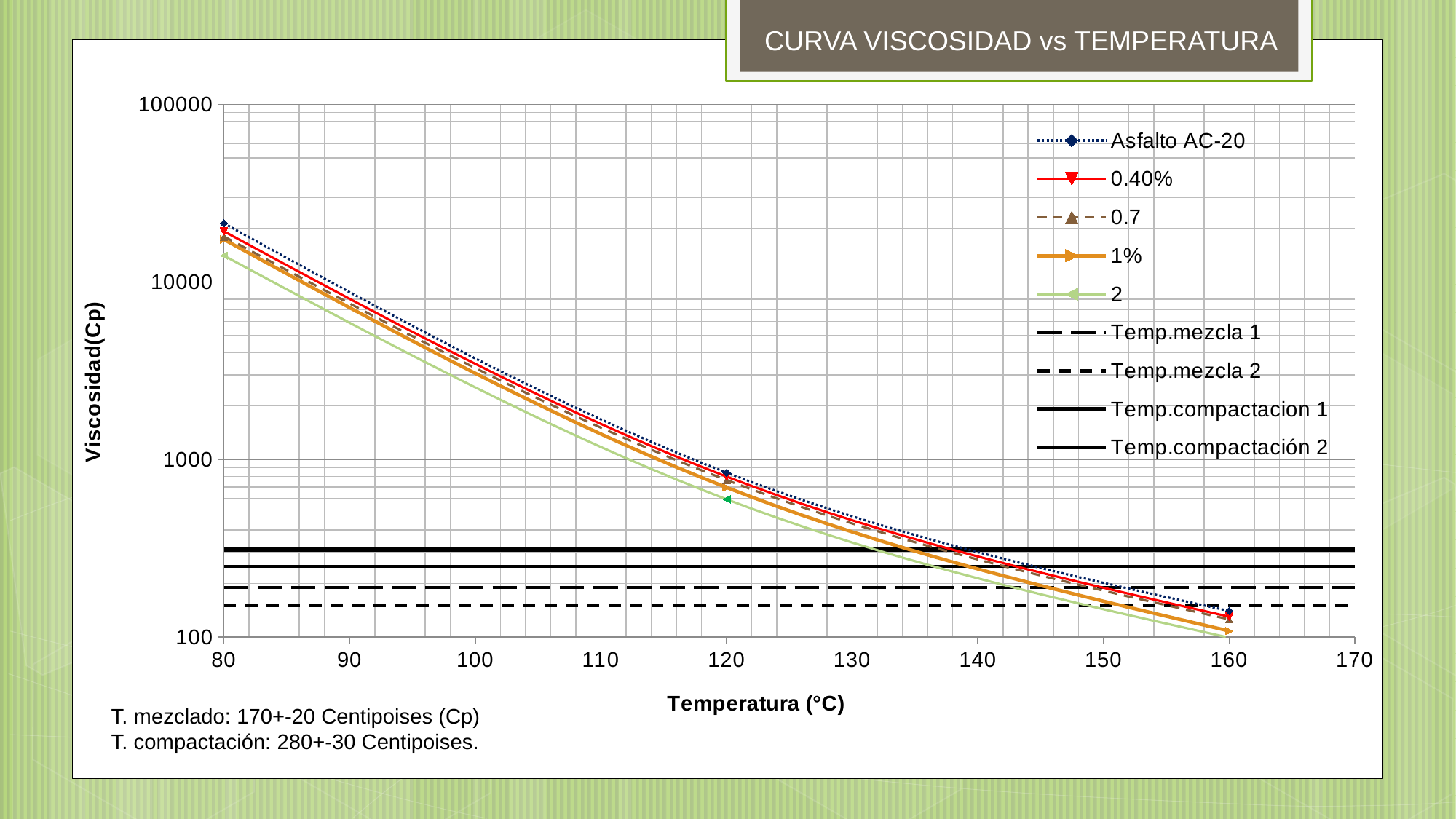
Is the viscosity of Asfalto AC-20 at 80 °C greater or less than 10000? greater What is the title of the chart? CURVA VISCOSIDAD vs TEMPERATURA What is the label of the y axis? Viscosidad(Cp) Is the viscosity of Asfalto AC-20 at 160 °C greater or less than 1000? less What type of chart is shown on the slide? line chart Is the viscosity of series 2 at 80 °C greater or less than 10000? greater As temperature increases along the x axis, do the viscosity curves rise or fall? fall Which horizontal reference line is higher, Temp.compactacion 1 or Temp.mezcla 2? Temp.compactacion 1 At 80 °C, which series has the lowest viscosity? 2 At 80 °C, which series has the highest viscosity? Asfalto AC-20 How many temperature points are plotted for each viscosity curve? 3 How many series does the legend list? 9